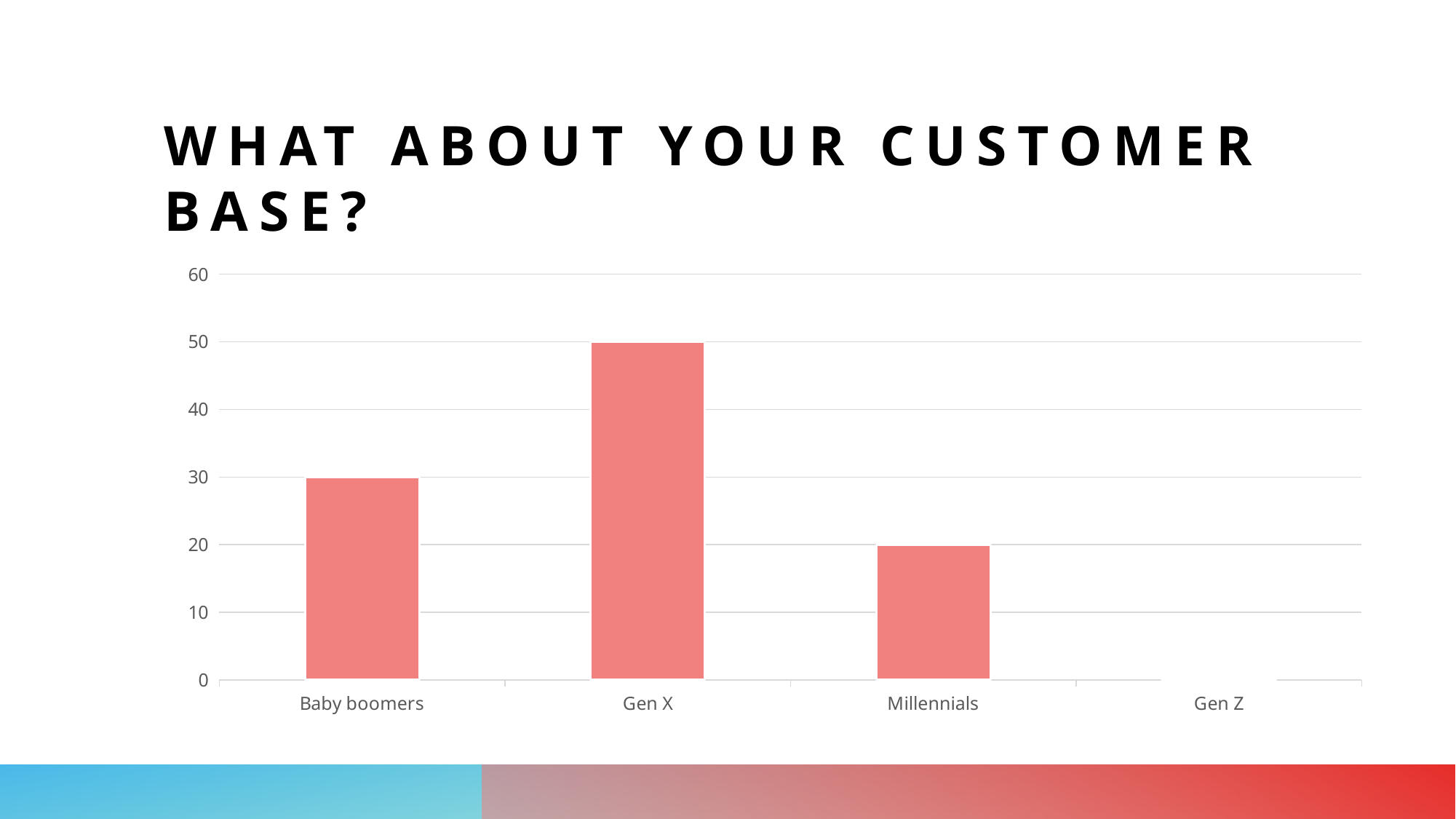
Which is larger, the value for Baby boomers or the value for Millennials? Baby boomers What is the difference between the values for Gen X and Millennials? 30 What is the value for Baby boomers? 30 Which category on the x axis has no visible bar? Gen Z Among the categories with a visible bar, which has the lowest value? Millennials Which category has the highest bar? Gen X What is the value for Gen X? 50 What kind of chart is shown on the slide? Bar chart What is the value for Millennials? 20 What is the difference between the values for Baby boomers and Millennials? 10 Is the value for Gen X greater or less than 40? greater How many categories are labelled on the x axis? 4